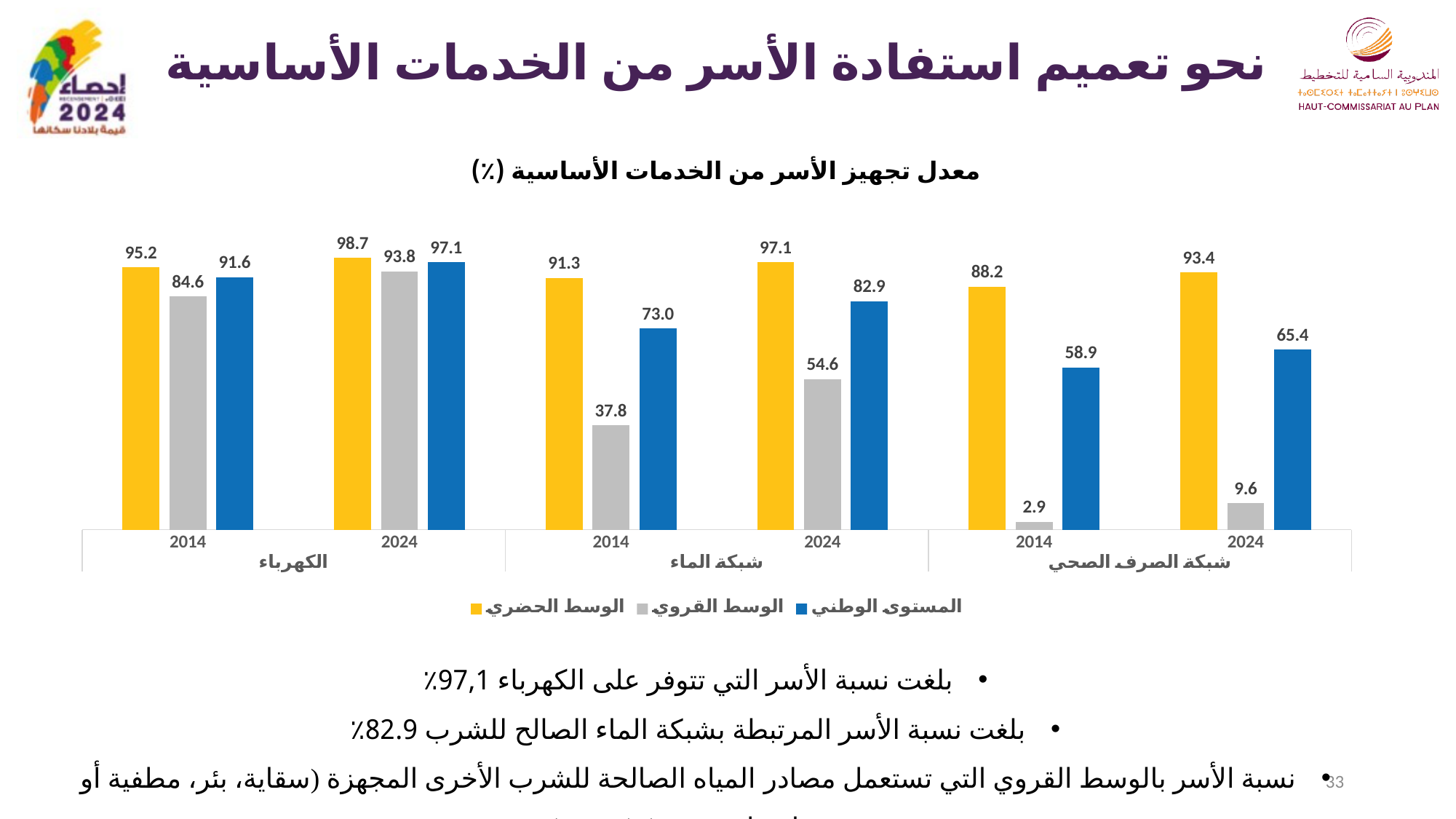
Which bar has the lowest value in the chart? الوسط القروي (rural), شبكة الصرف الصحي 2014 (2.9) What type of chart is shown on the slide? bar chart Did the الوسط القروي (rural) value for شبكة الصرف الصحي (sewerage network) rise or fall from 2014 to 2024? rise What is the value for الوسط القروي (rural) for شبكة الماء (water network) in 2014? 37.8 Which is larger: the الوسط القروي (rural) value for شبكة الماء in 2024 or the الوسط القروي value for الكهرباء in 2014? الكهرباء 2014 (84.6) Which series has the highest value for الكهرباء (electricity) in 2014? الوسط الحضري (urban) What is the value for المستوى الوطني (national) for شبكة الصرف الصحي (sewerage network) in 2024? 65.4 How many series does the legend list? 3 Which colour represents المستوى الوطني (national level) in the chart? blue What is the difference between the المستوى الوطني (national) values for شبكة الماء (water network) in 2024 and 2014? 9.9 What is the value for الوسط الحضري (urban) for الكهرباء (electricity) in 2024? 98.7 How many year groups (category pairs) are shown along the x axis? 6